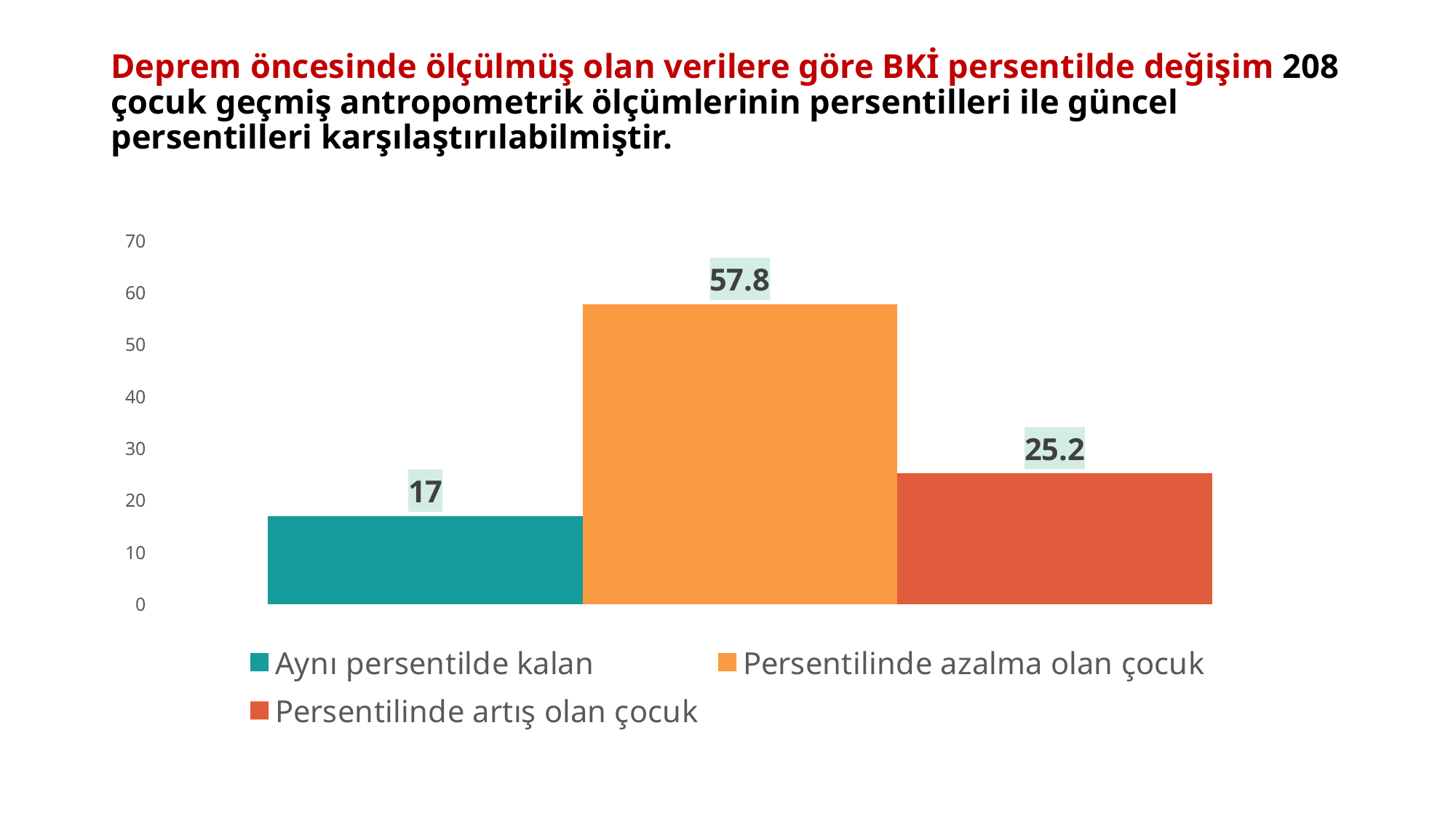
What kind of chart is shown on the slide? Bar chart What is the value for "Aynı persentilde kalan"? 17 Which series has the lowest value? Aynı persentilde kalan How many bars are plotted in the chart? 3 How many series does the legend list? 3 What is the difference between the values for "Persentilinde azalma olan çocuk" and "Persentilinde artış olan çocuk"? 32.6 Is the value for "Persentilinde azalma olan çocuk" greater or less than 50? greater What is the value for "Persentilinde artış olan çocuk"? 25.2 What is the difference between the values for "Persentilinde artış olan çocuk" and "Aynı persentilde kalan"? 8.2 Which series has the highest value? Persentilinde azalma olan çocuk Which is larger: the value for "Persentilinde artış olan çocuk" or "Aynı persentilde kalan"? Persentilinde artış olan çocuk What is the value for "Persentilinde azalma olan çocuk"? 57.8